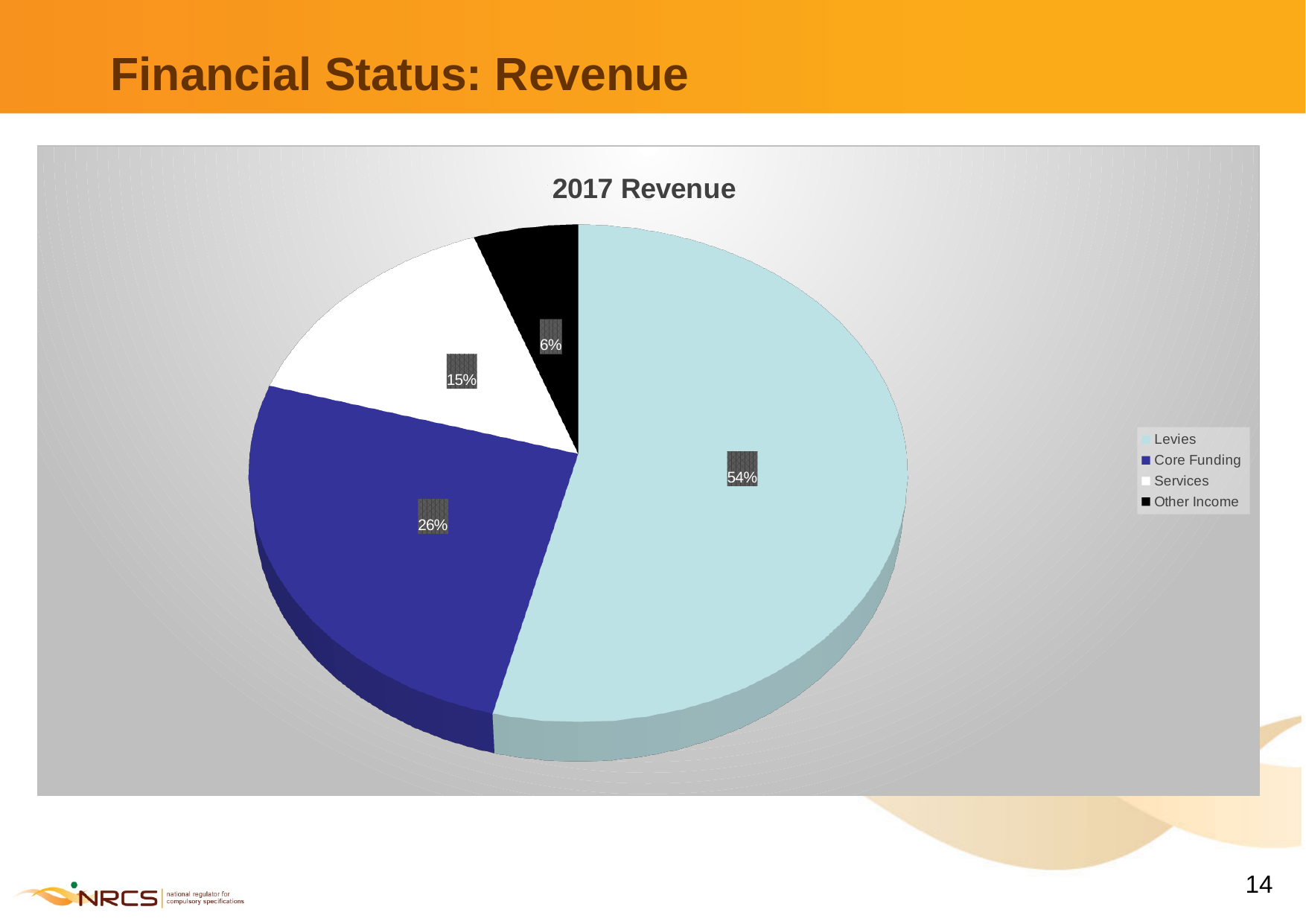
What share of 2017 Revenue comes from Services? 15% What share of 2017 Revenue comes from Levies? 54% How many revenue categories are shown in the pie chart? 4 What is the title of the chart? 2017 Revenue What share of 2017 Revenue comes from Core Funding? 26% What is the difference in percentage points between the Levies share and the Core Funding share? 28 Which revenue source has the smallest share of 2017 Revenue? Other Income Which has a larger share of 2017 Revenue, Core Funding or Services? Core Funding What is the difference in percentage points between the Services share and the Other Income share? 9 Which revenue source has the largest share of 2017 Revenue? Levies What kind of chart is shown on the slide? Pie chart